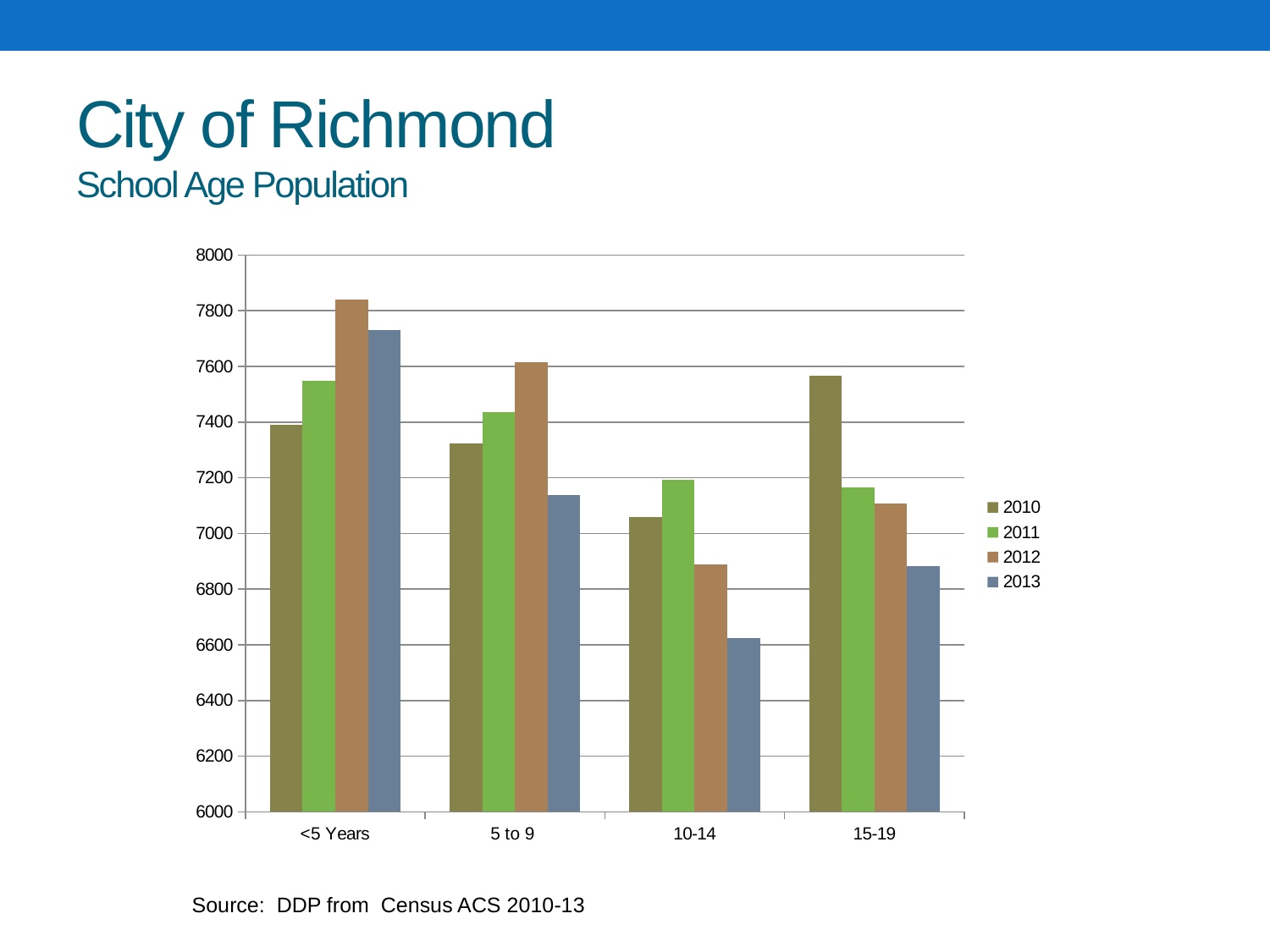
For the 15-19 age group, do the values rise or fall from 2010 to 2013? fall Which age group has the highest 2012 bar? <5 Years Which years are listed in the chart legend? 2010, 2011, 2012, 2013 Is the 2013 value for 10-14 greater or less than 6800? less Is the 2012 value for <5 Years greater or less than 7600? greater What kind of chart is shown on the slide? bar chart For the 15-19 age group, which is larger, the 2010 value or the 2013 value? 2010 Is the 2010 value for 15-19 greater or less than 7400? greater How many age-group categories are shown on the x axis? 4 How many series does the legend list? 4 For the 10-14 age group, which is larger, the 2011 value or the 2012 value? 2011 Which age group has the lowest 2013 bar? 10-14